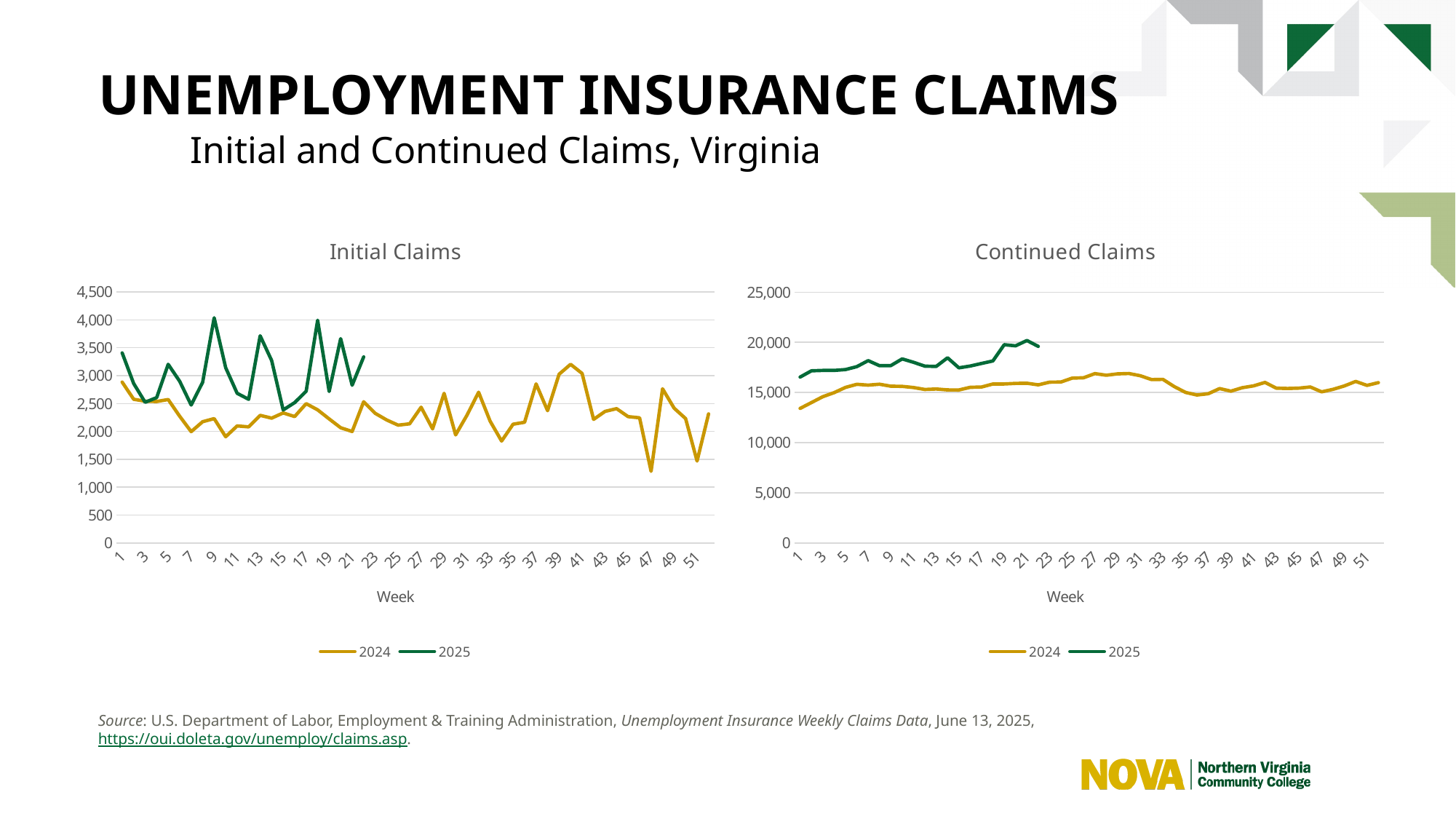
What kind of chart is the Initial Claims chart? line chart What is the x-axis label on the Initial Claims chart? Week In the Continued Claims chart, does the 2025 line generally rise or fall from week 1 to week 21? rise In the Continued Claims chart, does the 2024 line rise or fall from week 1 to week 5? rise How many series does the legend of the Continued Claims chart list? 2 In the Initial Claims chart, is the 2024 value at week 47 greater or less than 1,500? less In the Continued Claims chart, which colour represents the 2025 series? green In the Initial Claims chart, which series has the larger value at week 9, 2024 or 2025? 2025 In the Continued Claims chart, which series has the larger value at week 11, 2024 or 2025? 2025 In the Continued Claims chart, is the 2024 value at week 1 greater or less than 15,000? less In the Initial Claims chart, is the 2025 value at week 9 greater or less than 3,500? greater